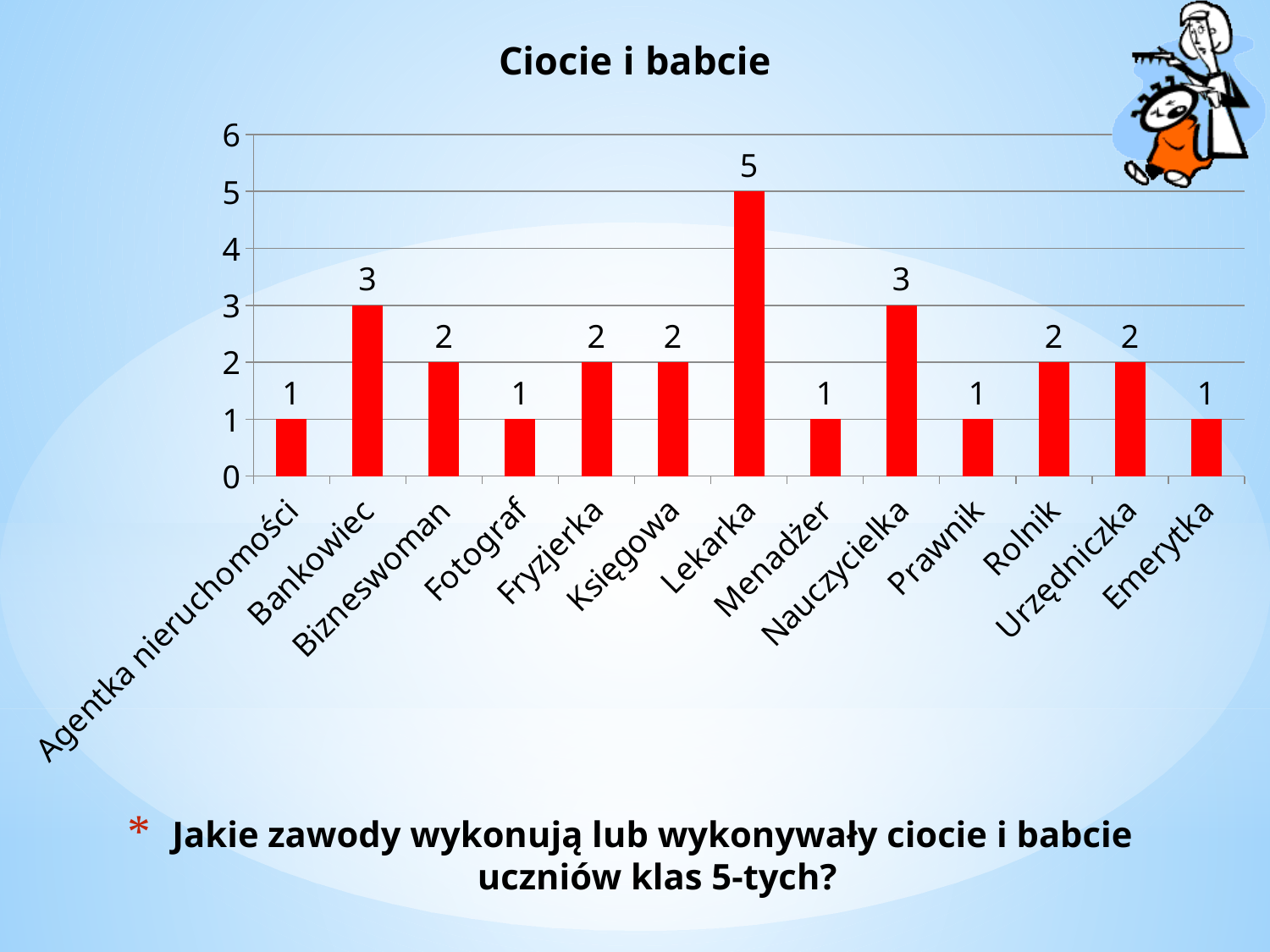
Which category has the highest value? Lekarka What is the difference between the values for Lekarka and Nauczycielka? 2 What kind of chart is shown on the slide? Bar chart What is the title of the chart? Ciocie i babcie How many categories are shown on the x axis? 13 Which is larger, the value for Rolnik or the value for Prawnik? Rolnik What is the value for Lekarka? 5 What is the value for Urzędniczka? 2 What is the value for Agentka nieruchomości? 1 What is the difference between the values for Bankowiec and Fotograf? 2 What is the value for Bankowiec? 3 Which is larger, the value for Nauczycielka or the value for Menadżer? Nauczycielka